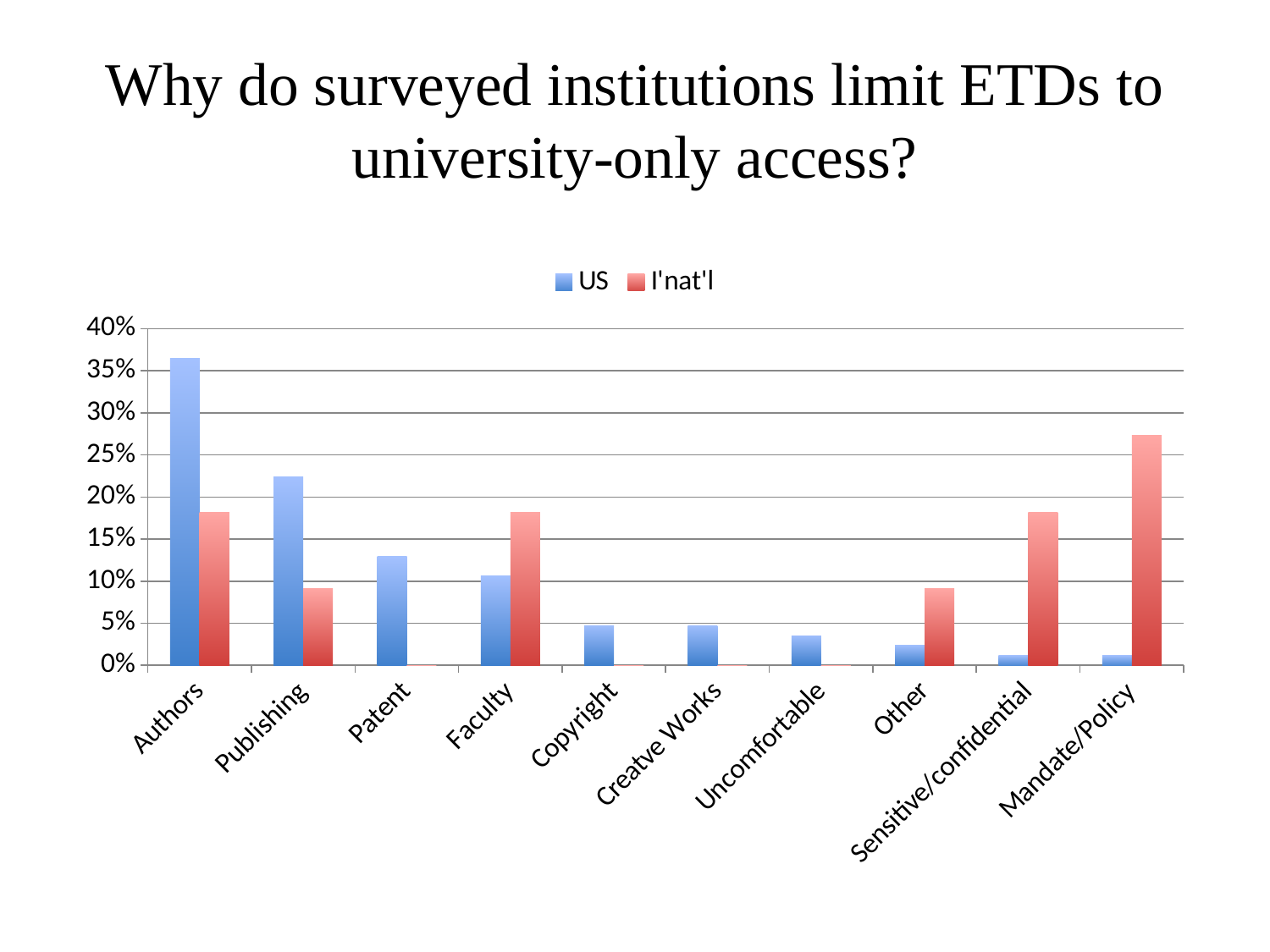
How many series does the legend list? 2 Is the I'nat'l value for Mandate/Policy greater or less than 25%? greater For Faculty, which series has the larger value, US or I'nat'l? I'nat'l How many categories are shown on the x axis? 10 Which colour represents the I'nat'l series in the legend? red For Publishing, which series has the larger value, US or I'nat'l? US Is the US value for Authors greater or less than 30%? greater What kind of chart is shown on the slide? bar chart Which category has the highest value for the I'nat'l series? Mandate/Policy Is the US value for Copyright greater or less than 10%? less Which category has the highest value for the US series? Authors